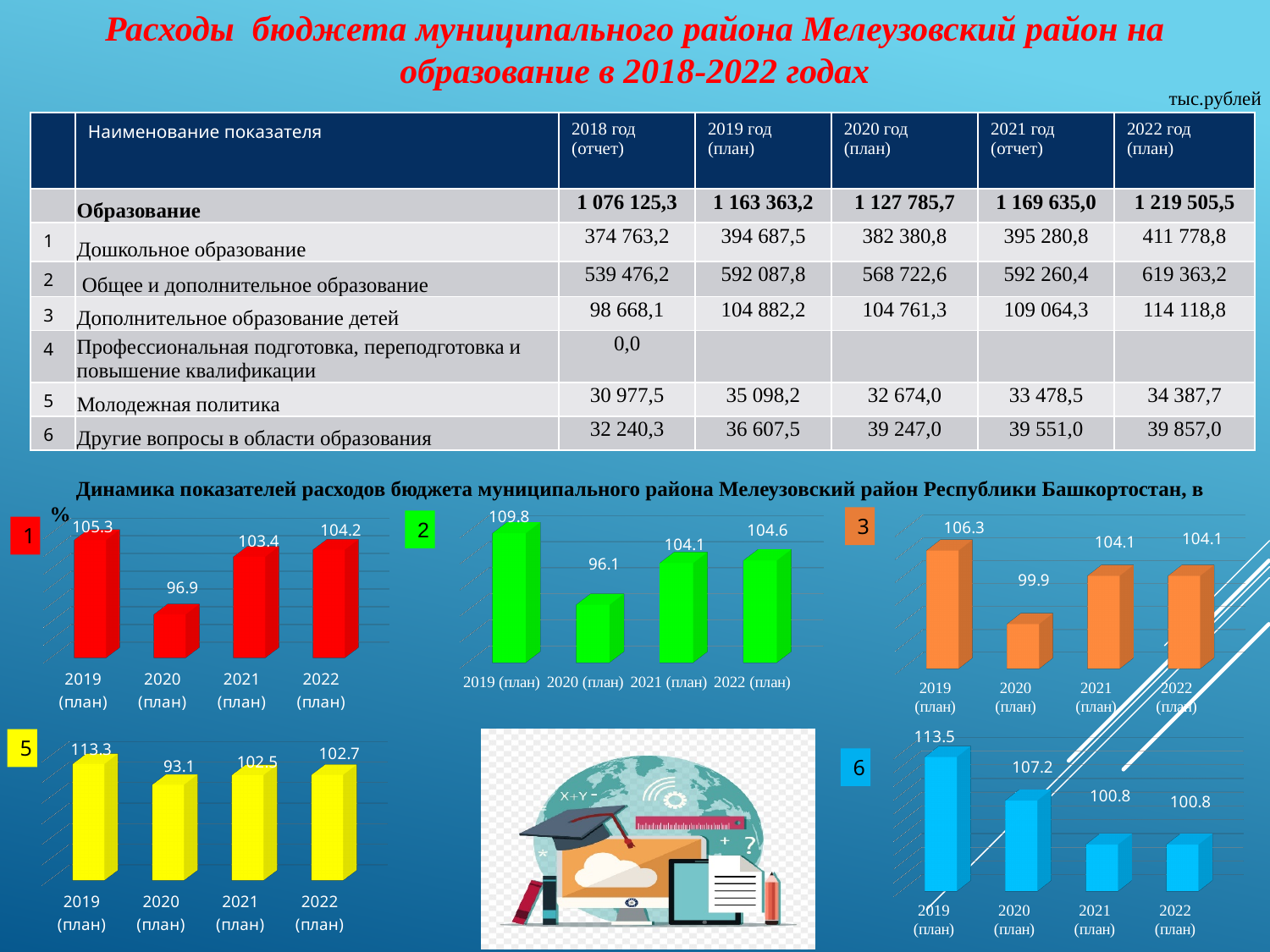
In the green bar chart labelled 2 (top centre), which year has the lowest value? 2020 (план) In the yellow bar chart labelled 5 (bottom left), which is larger, the value for 2020 (план) or 2021 (план)? 2021 (план) In the green bar chart labelled 2 (top centre), what is the difference between the values for 2019 (план) and 2020 (план)? 13.7 In the orange bar chart labelled 3 (top right), how many bars are plotted? 4 In the red bar chart labelled 1 (top left), which year has the highest value? 2019 (план) In the green bar chart labelled 2 (top centre), what is the value for 2019 (план)? 109.8 In the red bar chart labelled 1 (top left), what is the value for 2020 (план)? 96.9 In the blue bar chart labelled 6 (bottom right), what is the value for 2020 (план)? 107.2 What type of chart is the blue chart labelled 6 (bottom right)? bar chart In the yellow bar chart labelled 5 (bottom left), what is the value for 2019 (план)? 113.3 In the orange bar chart labelled 3 (top right), what is the value for 2020 (план)? 99.9 In the blue bar chart labelled 6 (bottom right), do the values rise or fall from 2019 (план) to 2022 (план)? fall